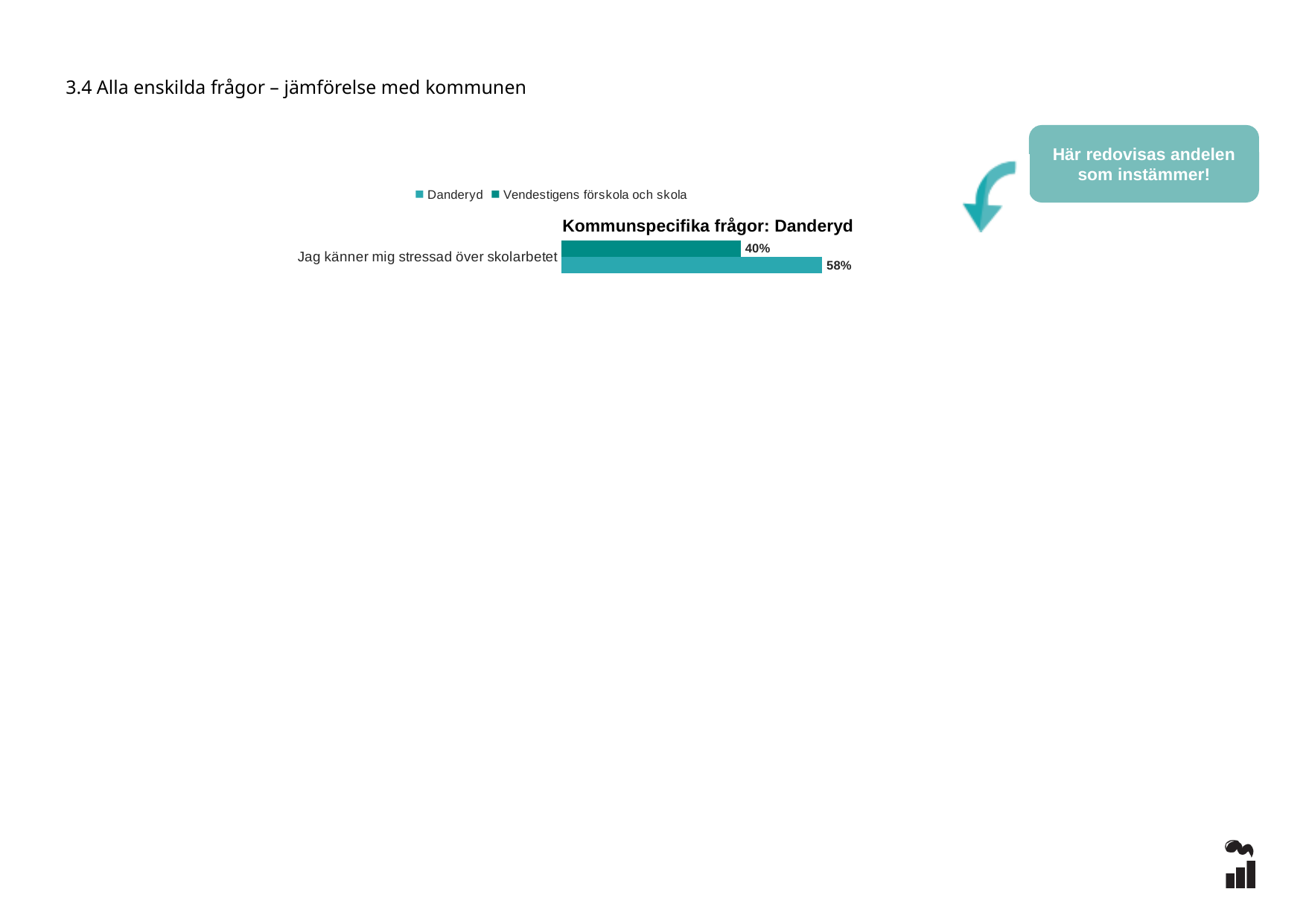
What type of chart is shown on the slide? bar chart What are the two series named in the legend? Danderyd and Vendestigens förskola och skola What is the title of the chart? Kommunspecifika frågor: Danderyd What is the difference between the Danderyd value and the Vendestigens förskola och skola value for 'Jag känner mig stressad över skolarbetet'? 18 percentage points How many categories (questions) are plotted in the chart? 1 How many series does the legend list? 2 What is the value for Danderyd for 'Jag känner mig stressad över skolarbetet'? 58% Which series has the lowest value in the chart? Vendestigens förskola och skola Which series has the higher value for 'Jag känner mig stressad över skolarbetet'? Danderyd What is the value for Vendestigens förskola och skola for 'Jag känner mig stressad över skolarbetet'? 40%